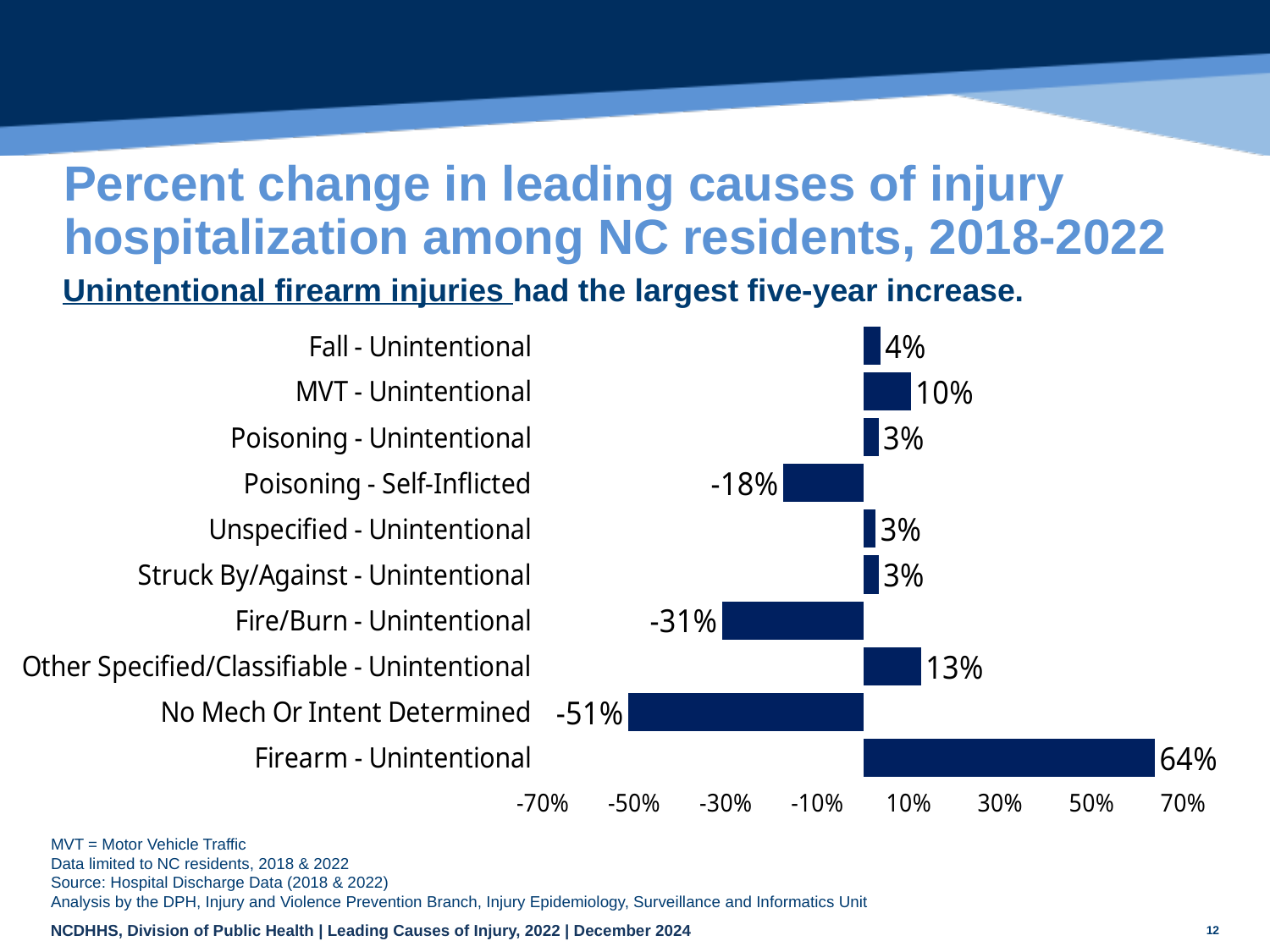
What does MVT stand for according to the slide? Motor Vehicle Traffic What is the percent change for Fire/Burn - Unintentional? -31% What is the percent change for No Mech Or Intent Determined? -51% How many categories show a negative percent change? 3 Which category has the largest percent change? Firearm - Unintentional What kind of chart is shown on the slide? Bar chart What is the percent change for Firearm - Unintentional? 64% What is the percent change for MVT - Unintentional? 10% Which has a larger percent change, Poisoning - Self-Inflicted or Fire/Burn - Unintentional? Poisoning - Self-Inflicted How many categories are shown in the chart? 10 Which category has the lowest percent change? No Mech Or Intent Determined What is the difference between the percent change for Other Specified/Classifiable - Unintentional and MVT - Unintentional? 3%